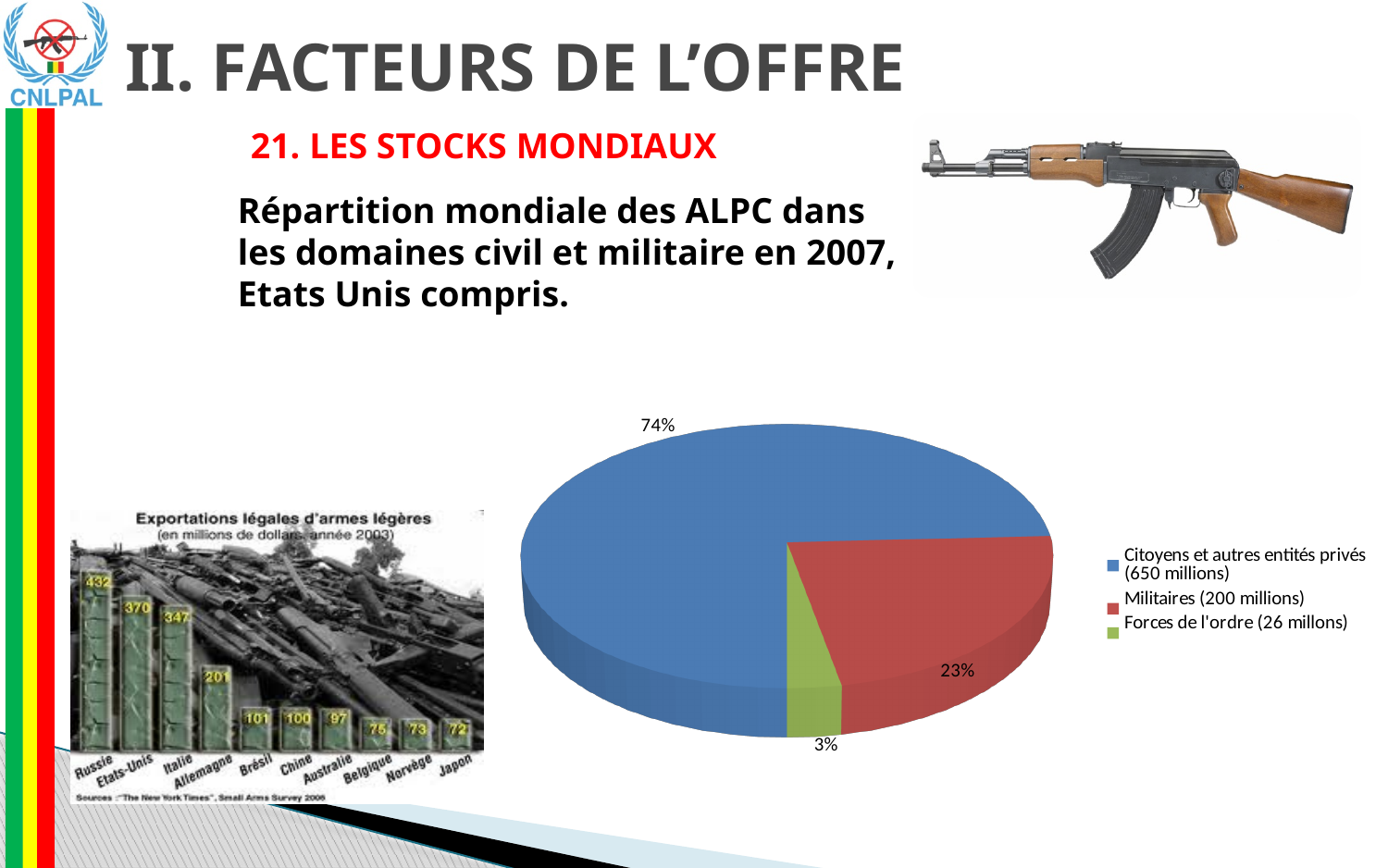
On the bar chart 'Exportations légales d'armes légères', how many countries are shown? 10 On the pie chart, what share is shown for Militaires? 23% On the pie chart, what is the difference in percentage points between the Militaires slice and the Forces de l'ordre slice? 20 On the bar chart 'Exportations légales d'armes légères', what is the value for Russie? 432 What kind of chart is the chart in the centre of the slide? Pie chart On the pie chart, how many categories does the legend list? 3 On the pie chart, which category has the largest slice? Citoyens et autres entités privés On the pie chart, what share is shown for Citoyens et autres entités privés? 74% On the pie chart, which category has the smallest slice? Forces de l'ordre On the bar chart 'Exportations légales d'armes légères', which country has the highest value? Russie On the pie chart, what colour is the Militaires slice? Red On the pie chart, what share is shown for Forces de l'ordre? 3%